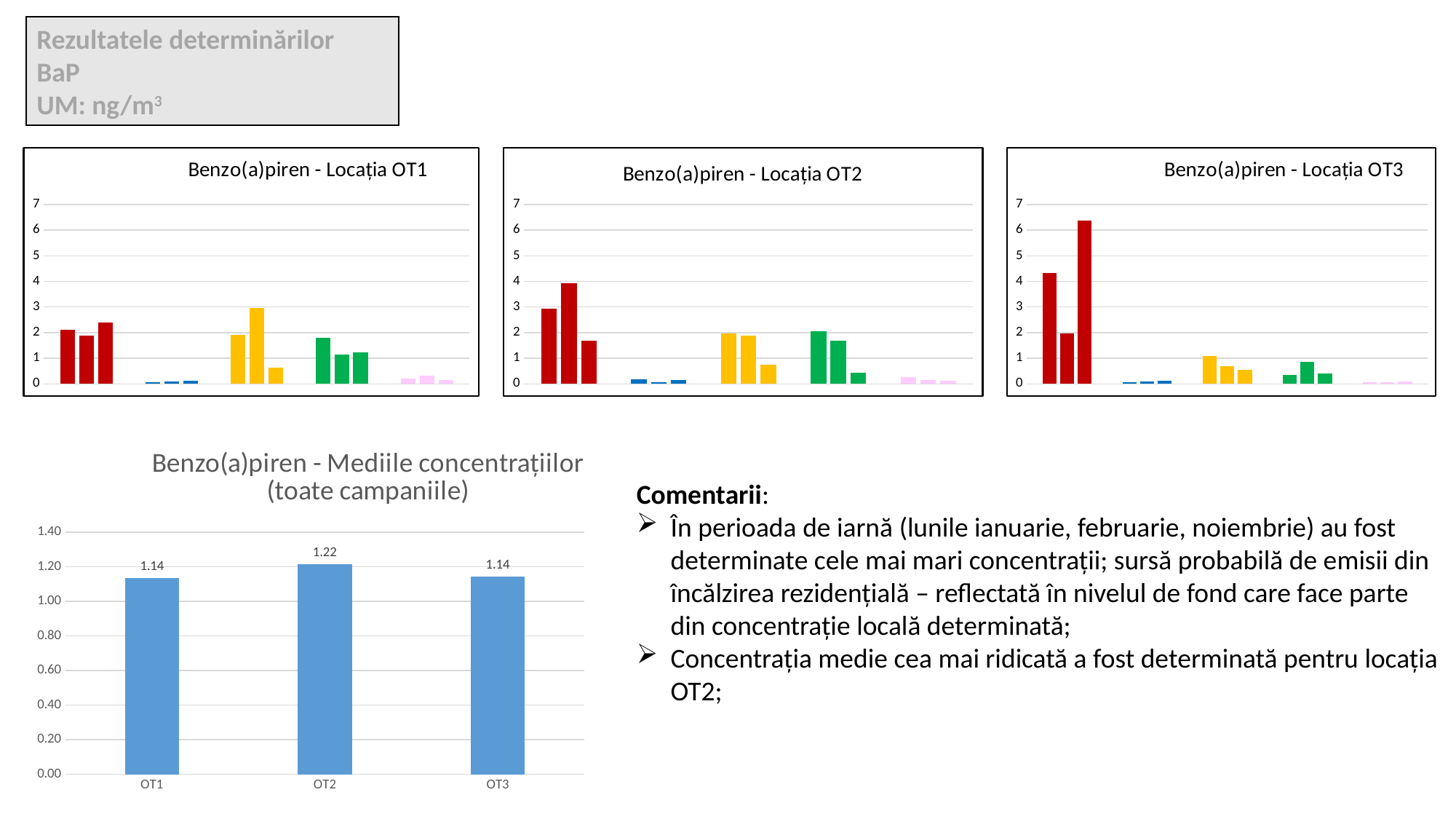
In the 'Benzo(a)piren - Mediile concentrațiilor (toate campaniile)' chart, what is the difference between the values for OT2 and OT1? 0.08 In the 'Benzo(a)piren - Mediile concentrațiilor (toate campaniile)' chart, what is the value for OT2? 1.22 In the 'Benzo(a)piren - Mediile concentrațiilor (toate campaniile)' chart, which is larger, the value for OT2 or the value for OT3? OT2 In the 'Benzo(a)piren - Mediile concentrațiilor (toate campaniile)' chart, is the value for OT2 greater or less than 1.00? greater What kind of chart is the 'Benzo(a)piren - Mediile concentrațiilor (toate campaniile)' chart? bar chart In the 'Benzo(a)piren - Locația OT1' chart, is the tallest bar greater or less than 4? less What is the title of the chart at the top right of the slide? Benzo(a)piren - Locația OT3 In the 'Benzo(a)piren - Mediile concentrațiilor (toate campaniile)' chart, what is the value for OT3? 1.14 In the 'Benzo(a)piren - Locația OT3' chart, is the tallest bar greater or less than 6? greater How many locations are shown in the 'Benzo(a)piren - Mediile concentrațiilor (toate campaniile)' chart? 3 In the 'Benzo(a)piren - Mediile concentrațiilor (toate campaniile)' chart, which location has the highest value? OT2 In the 'Benzo(a)piren - Mediile concentrațiilor (toate campaniile)' chart, what is the value for OT1? 1.14